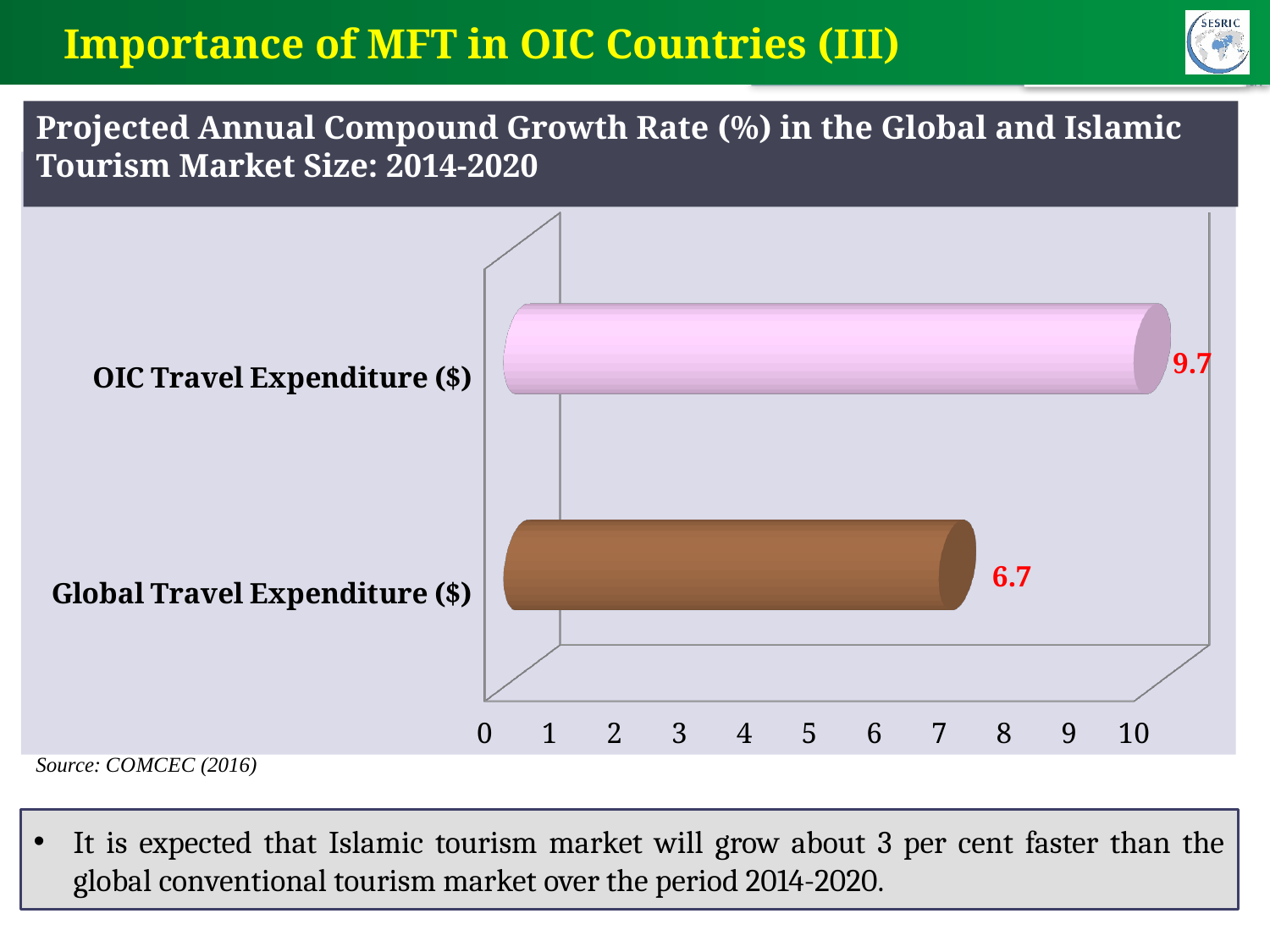
What is the source cited for the chart? COMCEC (2016) Is the value for OIC Travel Expenditure ($) greater or less than 9? greater What kind of chart is shown on the slide? bar chart Which category has the lower projected growth rate? Global Travel Expenditure ($) Is the value for Global Travel Expenditure ($) greater or less than 7? less How many categories are shown in the chart? 2 What is the title of the chart? Projected Annual Compound Growth Rate (%) in the Global and Islamic Tourism Market Size: 2014-2020 Which category has the higher projected growth rate? OIC Travel Expenditure ($) What is the difference between the growth rates for OIC Travel Expenditure ($) and Global Travel Expenditure ($)? 3 What is the projected annual compound growth rate for Global Travel Expenditure ($)? 6.7 Is the value for OIC Travel Expenditure ($) larger or smaller than the value for Global Travel Expenditure ($)? larger What is the projected annual compound growth rate for OIC Travel Expenditure ($)? 9.7